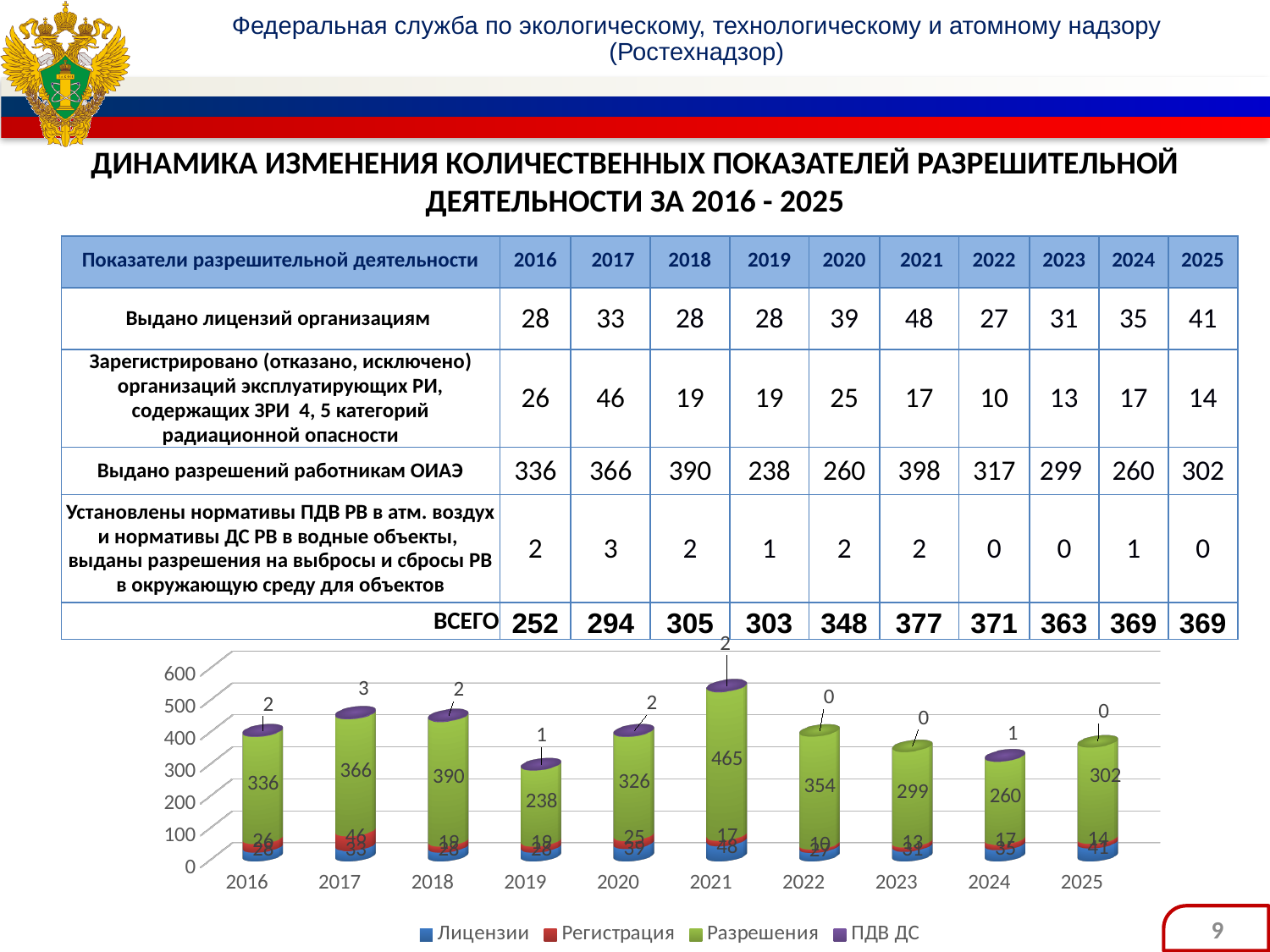
In the chart, which year has the lowest Разрешения value? 2019 In the chart, is the Разрешения value larger for 2022 or for 2023? 2022 How many series does the chart legend list? 4 What kind of chart is shown at the bottom of the slide? bar chart In the chart, what is the value of the Разрешения segment for 2021? 465 In the chart, what is the difference between the Разрешения values for 2018 and 2019? 152 How many years are shown along the x axis of the chart? 10 What are the four entries in the chart legend? Лицензии, Регистрация, Разрешения, ПДВ ДС In the chart, what is the value of the Разрешения segment for 2019? 238 In the chart, what is the value of the ПДВ ДС segment for 2017? 3 In the chart, which year has the highest Разрешения value? 2021 In the chart, is the total height of the 2021 bar greater or less than 500? greater